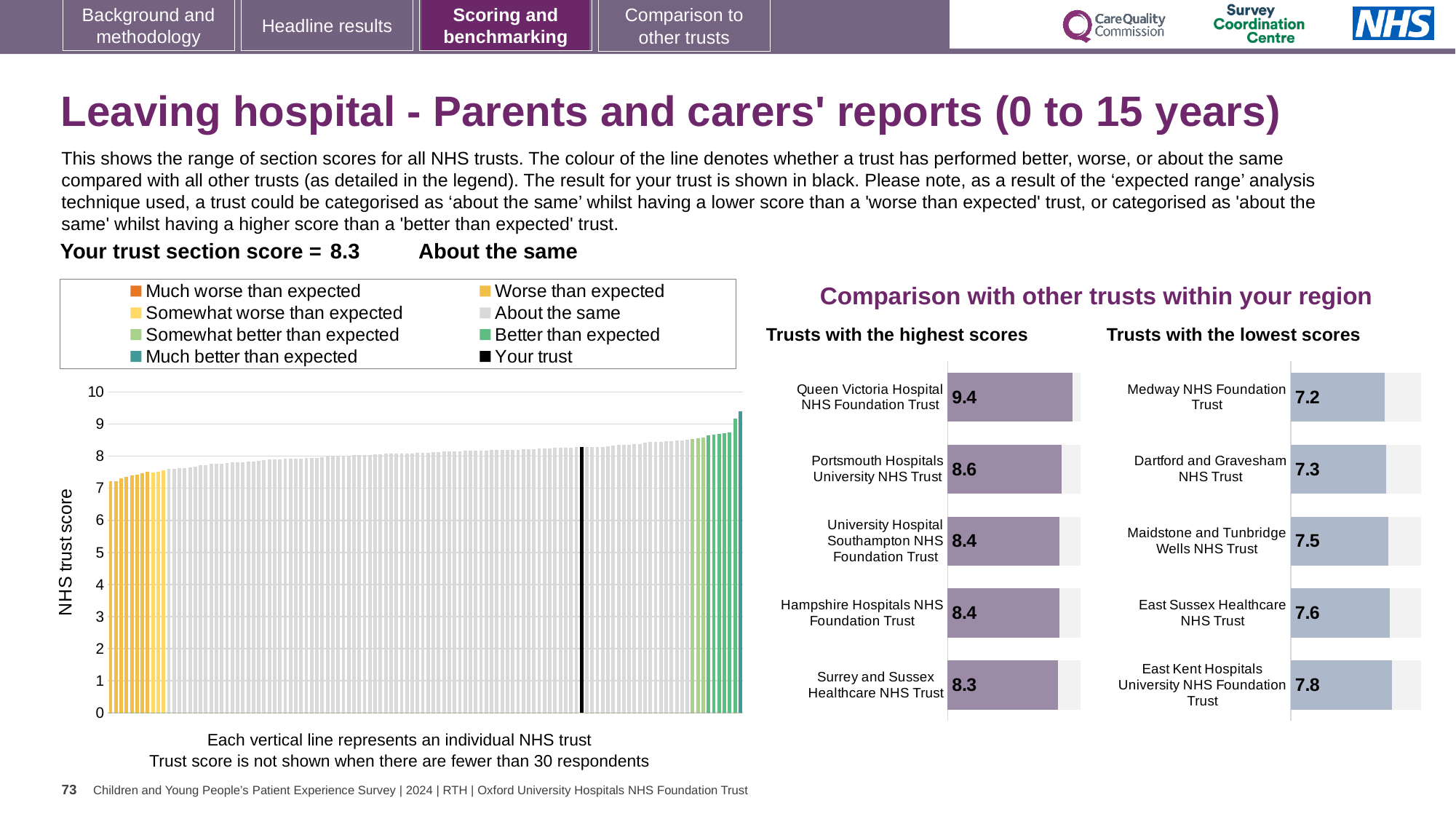
In the 'Trusts with the highest scores' chart, which trust has the lowest score shown? Surrey and Sussex Healthcare NHS Trust In the 'Trusts with the lowest scores' chart, what is the score for East Kent Hospitals University NHS Foundation Trust? 7.8 In the 'Trusts with the lowest scores' chart, which has the larger score: Dartford and Gravesham NHS Trust or Maidstone and Tunbridge Wells NHS Trust? Maidstone and Tunbridge Wells NHS Trust In the 'Trusts with the lowest scores' chart, what is the score for Medway NHS Foundation Trust? 7.2 How many entries does the legend of the main chart on the left list? 8 In the main chart on the left, what is the section score for your trust (the black line)? 8.3 In the 'Trusts with the lowest scores' chart, which trust has the highest score shown? East Kent Hospitals University NHS Foundation Trust In the 'Trusts with the highest scores' chart, what is the difference between the scores of Queen Victoria Hospital NHS Foundation Trust and Portsmouth Hospitals University NHS Trust? 0.8 In the 'Trusts with the highest scores' chart, what is the score for Queen Victoria Hospital NHS Foundation Trust? 9.4 In the main chart on the left, is the value of the tallest bar greater or less than 9? greater How many trusts are listed in the 'Trusts with the lowest scores' chart? 5 In the 'Trusts with the highest scores' chart, what is the score for Portsmouth Hospitals University NHS Trust? 8.6